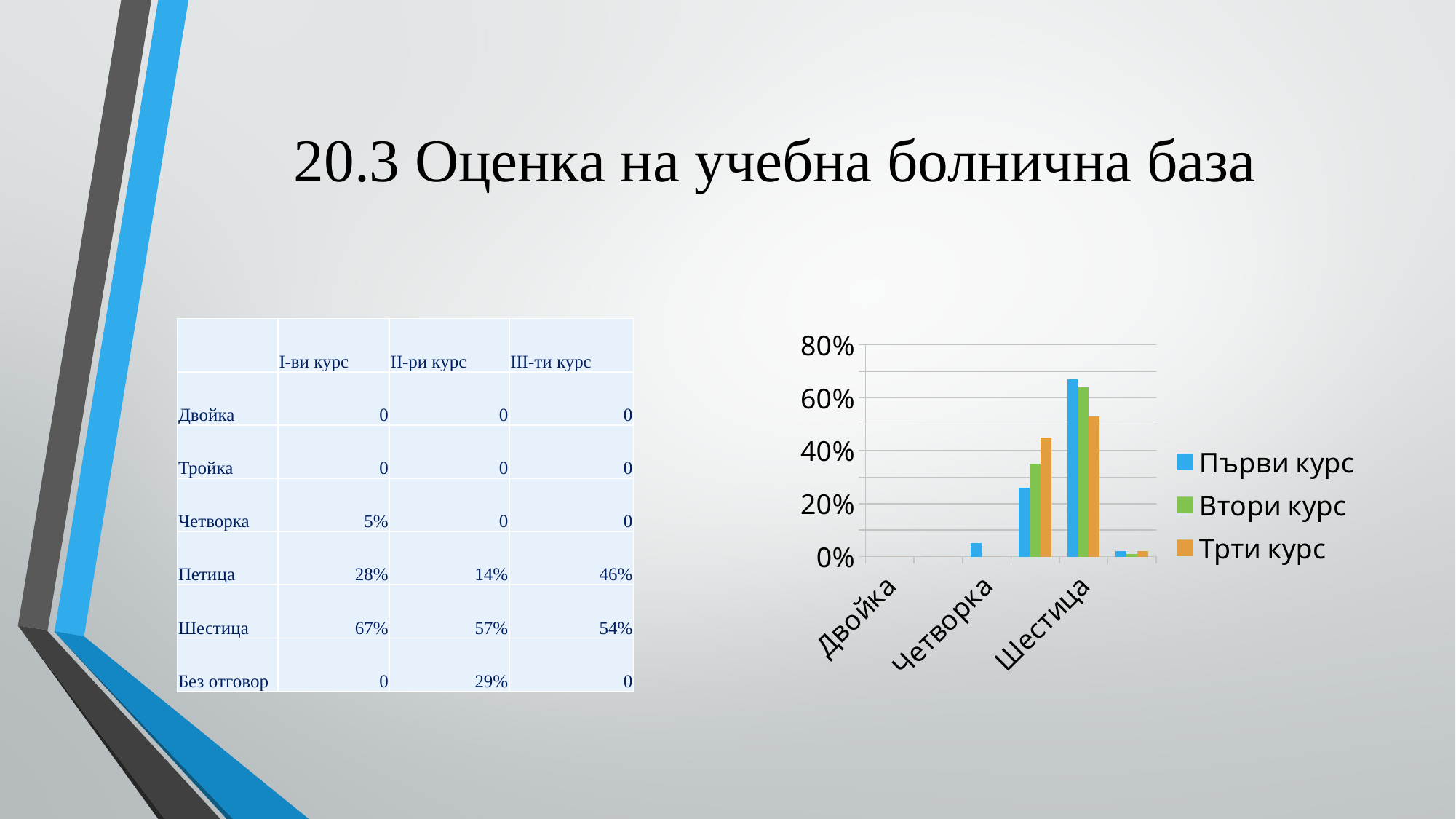
At Шестица, which is larger: Втори курс or Трти курс? Втори курс How many series does the chart legend list? 3 Is the value for Първи курс at Шестица greater or less than 60%? greater What is the highest value shown on the chart's y axis? 80% Which series does the chart legend list first? Първи курс Is the value for Трти курс at Шестица greater or less than 60%? less Which labelled category on the x axis has the tallest bars? Шестица Which series has the tallest bar at Шестица? Първи курс What kind of chart is shown on the slide? bar chart Is the value for Първи курс at Четворка greater or less than 20%? less Which series has the shortest bar at Шестица? Трти курс What colour are the bars for Трти курс in the chart? orange